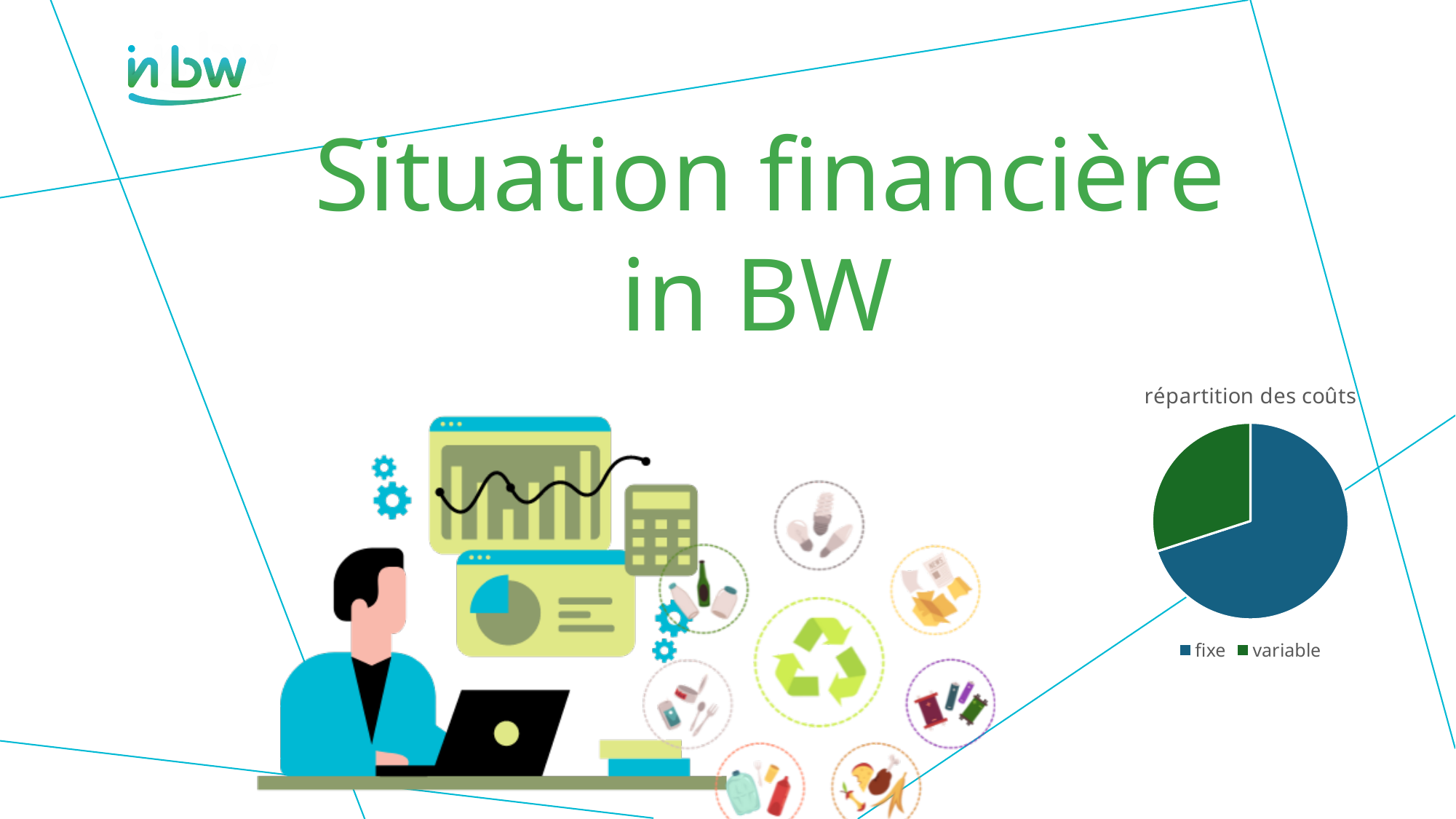
How many slices does the pie chart have? 2 In the pie chart, which is larger: fixe or variable? fixe Which slice of the pie chart is the largest? fixe How many entries does the legend of the pie chart list? 2 Which slice of the pie chart is the smallest? variable Does the 'fixe' slice take up more or less than half of the pie chart? more What colour is the 'fixe' slice in the pie chart? blue What is the title of the pie chart? répartition des coûts What kind of chart is shown on the slide? pie chart